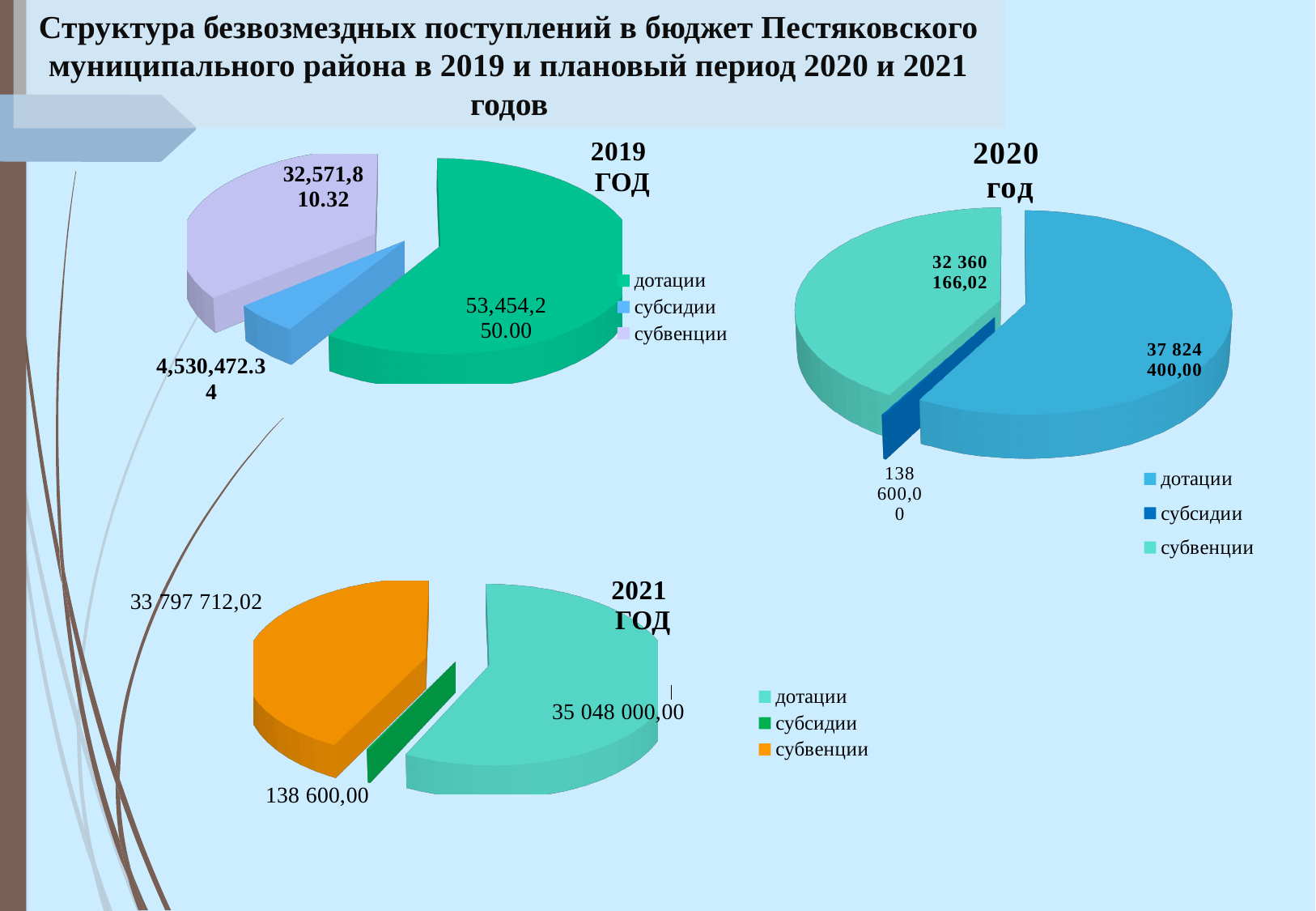
In the 2020 год chart, which is larger: дотации or субвенции? дотации What kind of charts are shown on the slide? pie charts In the 2019 год chart, which category has the largest slice? дотации How many pie charts are on the slide? 3 In the 2021 год chart, what is the value for субсидии? 138 600,00 In the 2019 год chart, what is the value for дотации? 53,454,250.00 In the 2021 год chart, what is the value for дотации? 35 048 000,00 How many categories does the legend of the 2021 год chart list? 3 In the 2020 год chart, what is the value for дотации? 37 824 400,00 In the 2021 год chart, which category has the smallest slice? субсидии In the 2020 год chart, what is the difference between дотации and субвенции? 5 464 233,98 In the 2020 год chart, what is the value for субвенции? 32 360 166,02